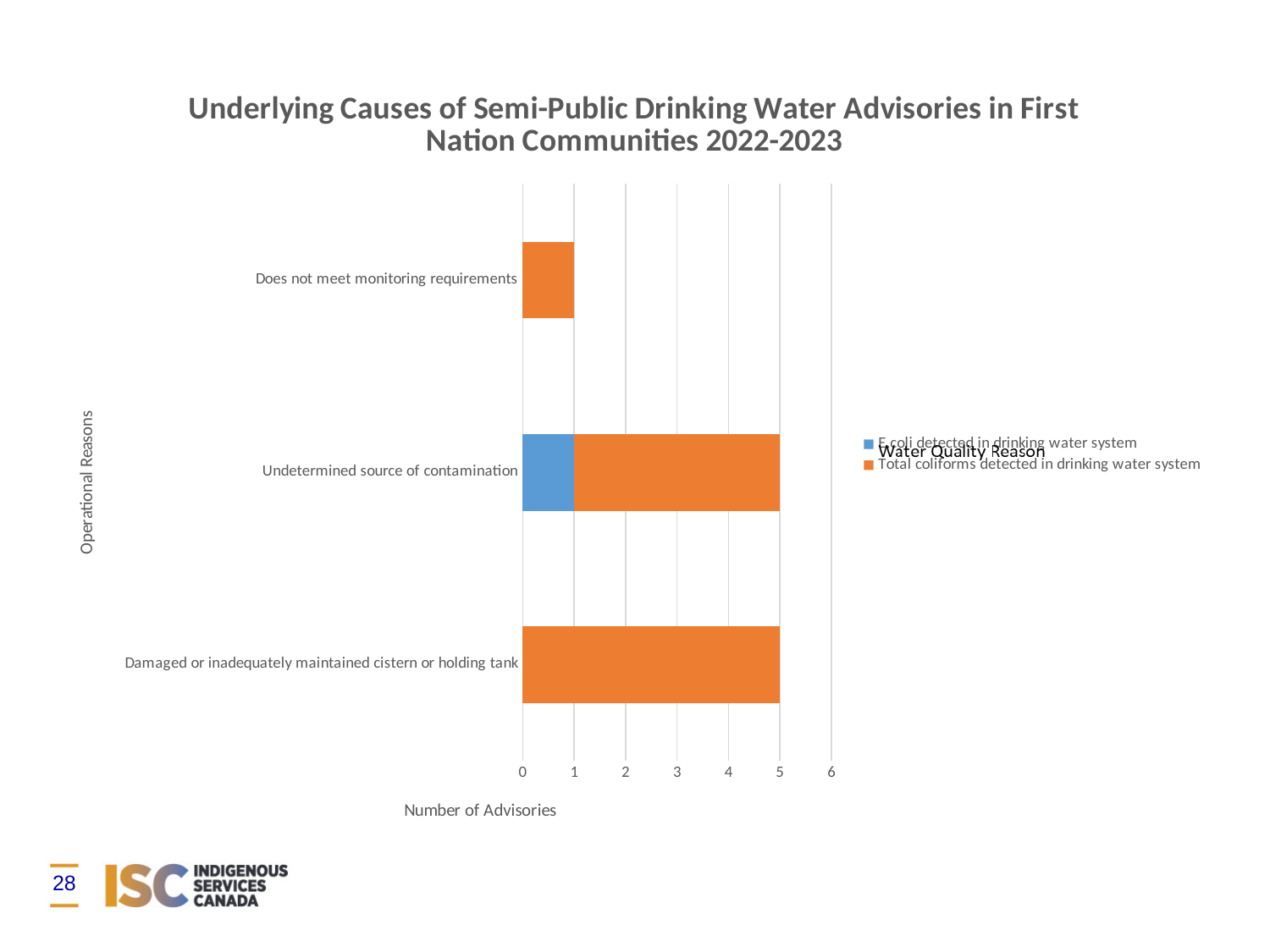
Is the total number of advisories for 'Damaged or inadequately maintained cistern or holding tank' greater or less than 3? greater Which has more advisories: 'Damaged or inadequately maintained cistern or holding tank' or 'Does not meet monitoring requirements'? Damaged or inadequately maintained cistern or holding tank Which operational reason has the lowest total number of advisories? Does not meet monitoring requirements What is the number of advisories for 'Does not meet monitoring requirements'? 1 What is the difference in total advisories between 'Damaged or inadequately maintained cistern or holding tank' and 'Does not meet monitoring requirements'? 4 What is the total number of advisories for 'Undetermined source of contamination'? 5 How many operational reason categories are plotted on the chart? 3 What is the title of the horizontal axis? Number of Advisories How many advisories for 'Undetermined source of contamination' are due to E. coli detected in drinking water system? 1 What is the total number of advisories for 'Damaged or inadequately maintained cistern or holding tank'? 5 How many series does the legend list? 2 What kind of chart is shown on the slide? Stacked bar chart